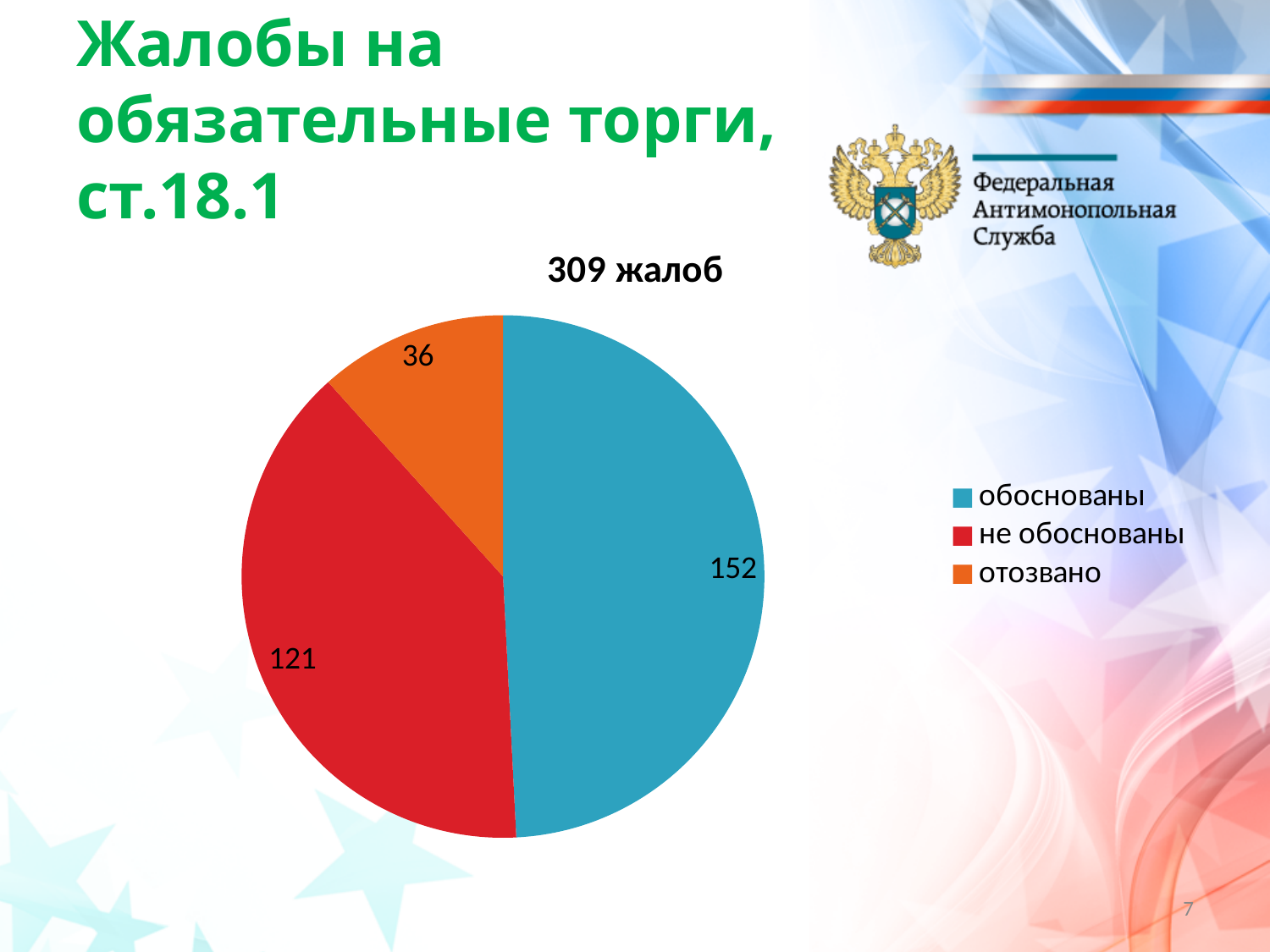
What is the value for "отозвано"? 36 Which category has the smallest slice? отозвано How many slices does the pie chart have? 3 What is the title of the chart? 309 жалоб What is the value for "обоснованы"? 152 Which category has the largest slice? обоснованы What colour is the slice for "отозвано"? orange What is the difference between the values for "обоснованы" and "не обоснованы"? 31 Which is larger, the value for "не обоснованы" or the value for "отозвано"? не обоснованы How many entries does the legend list? 3 What is the value for "не обоснованы"? 121 What kind of chart is shown on the slide? pie chart